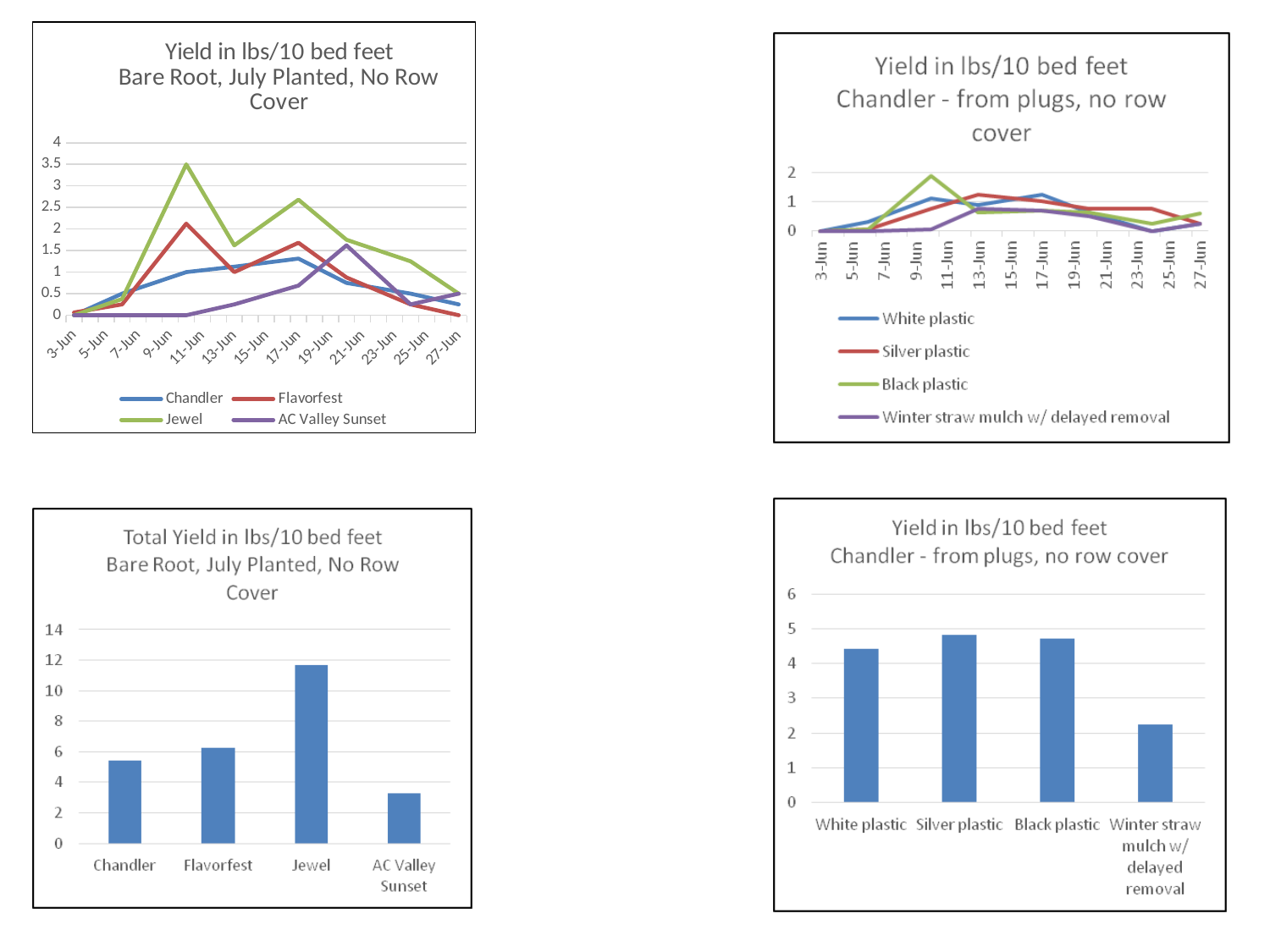
In the top-left chart titled 'Yield in lbs/10 bed feet Bare Root, July Planted, No Row Cover', how many series does the legend list? 4 In the bottom-right chart titled 'Yield in lbs/10 bed feet Chandler - from plugs, no row cover', which treatment has the lowest yield? Winter straw mulch w/ delayed removal In the top-right chart titled 'Yield in lbs/10 bed feet Chandler - from plugs, no row cover', which series is drawn in green? Black plastic In the bottom-right chart titled 'Yield in lbs/10 bed feet Chandler - from plugs, no row cover', is the value for Winter straw mulch w/ delayed removal greater or less than 3? less In the top-left chart titled 'Yield in lbs/10 bed feet Bare Root, July Planted, No Row Cover', is the value for Jewel on 11-Jun greater or less than 3? greater In the bottom-left chart titled 'Total Yield in lbs/10 bed feet Bare Root, July Planted, No Row Cover', how many varieties are shown? 4 In the bottom-left chart titled 'Total Yield in lbs/10 bed feet Bare Root, July Planted, No Row Cover', which variety has the lowest total yield? AC Valley Sunset In the bottom-right chart titled 'Yield in lbs/10 bed feet Chandler - from plugs, no row cover', what kind of chart is it? bar chart In the bottom-left chart titled 'Total Yield in lbs/10 bed feet Bare Root, July Planted, No Row Cover', which is larger, the value for Flavorfest or the value for Chandler? Flavorfest In the bottom-left chart titled 'Total Yield in lbs/10 bed feet Bare Root, July Planted, No Row Cover', is the value for Jewel greater or less than 10? greater In the bottom-left chart titled 'Total Yield in lbs/10 bed feet Bare Root, July Planted, No Row Cover', which variety has the highest total yield? Jewel